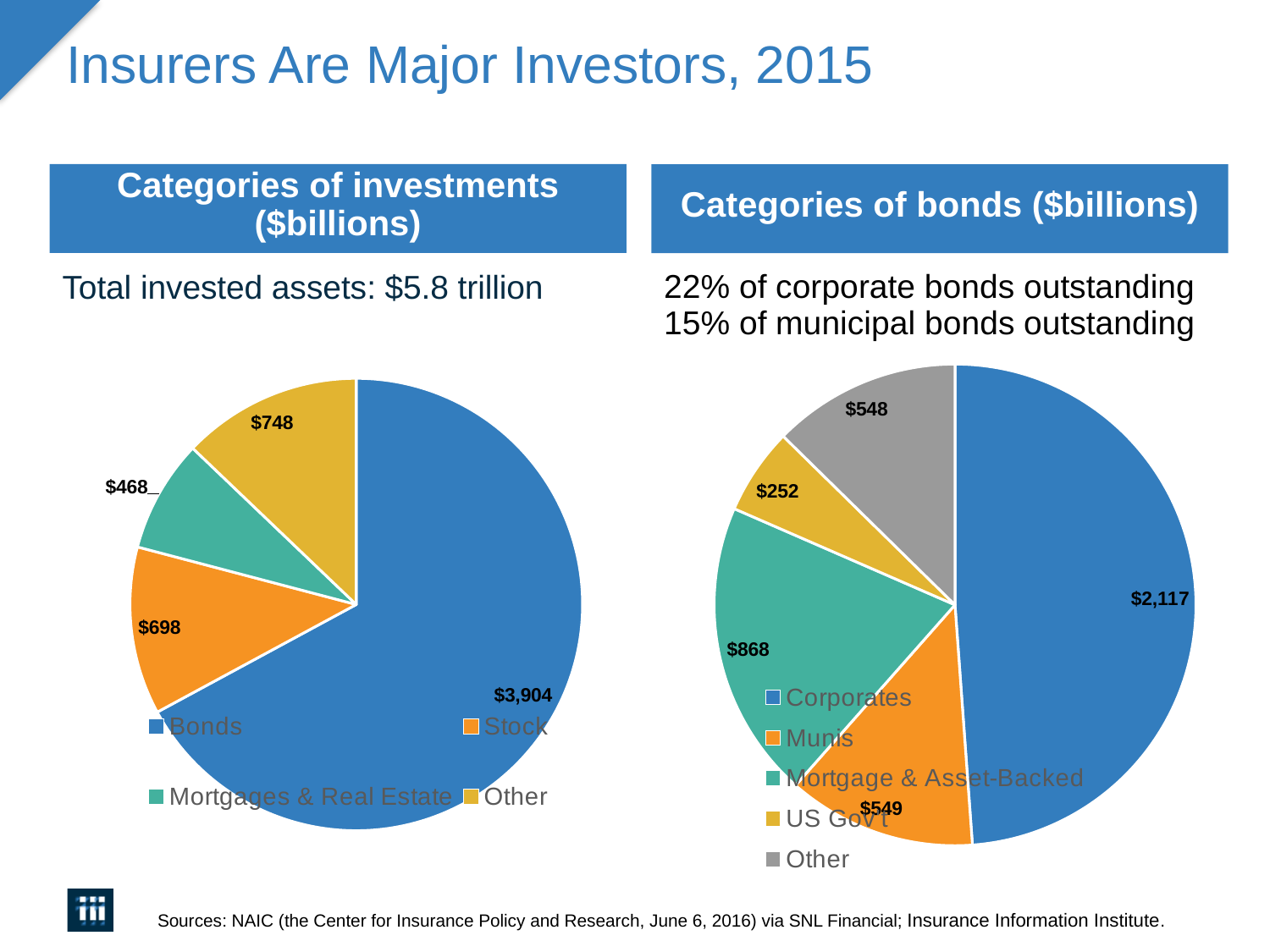
How many categories does the 'Categories of bonds ($billions)' pie chart show? 5 How many categories does the 'Categories of investments ($billions)' pie chart show? 4 In the 'Categories of bonds ($billions)' pie chart, what is the value for Corporates? $2,117 In the 'Categories of investments ($billions)' pie chart, what is the value for Bonds? $3,904 In the 'Categories of bonds ($billions)' pie chart, what is the value for US Gov't? $252 What type of chart is used for 'Categories of bonds ($billions)'? Pie chart In the 'Categories of bonds ($billions)' pie chart, what is the difference between Corporates and Mortgage & Asset-Backed? $1,249 In the 'Categories of investments ($billions)' pie chart, which category is the smallest? Mortgages & Real Estate In the 'Categories of bonds ($billions)' pie chart, which category is the largest? Corporates In the 'Categories of investments ($billions)' pie chart, which is larger, Stock or Other? Other In the 'Categories of investments ($billions)' pie chart, what is the value for Mortgages & Real Estate? $468 In the 'Categories of investments ($billions)' pie chart, what is the difference between Bonds and Stock? $3,206